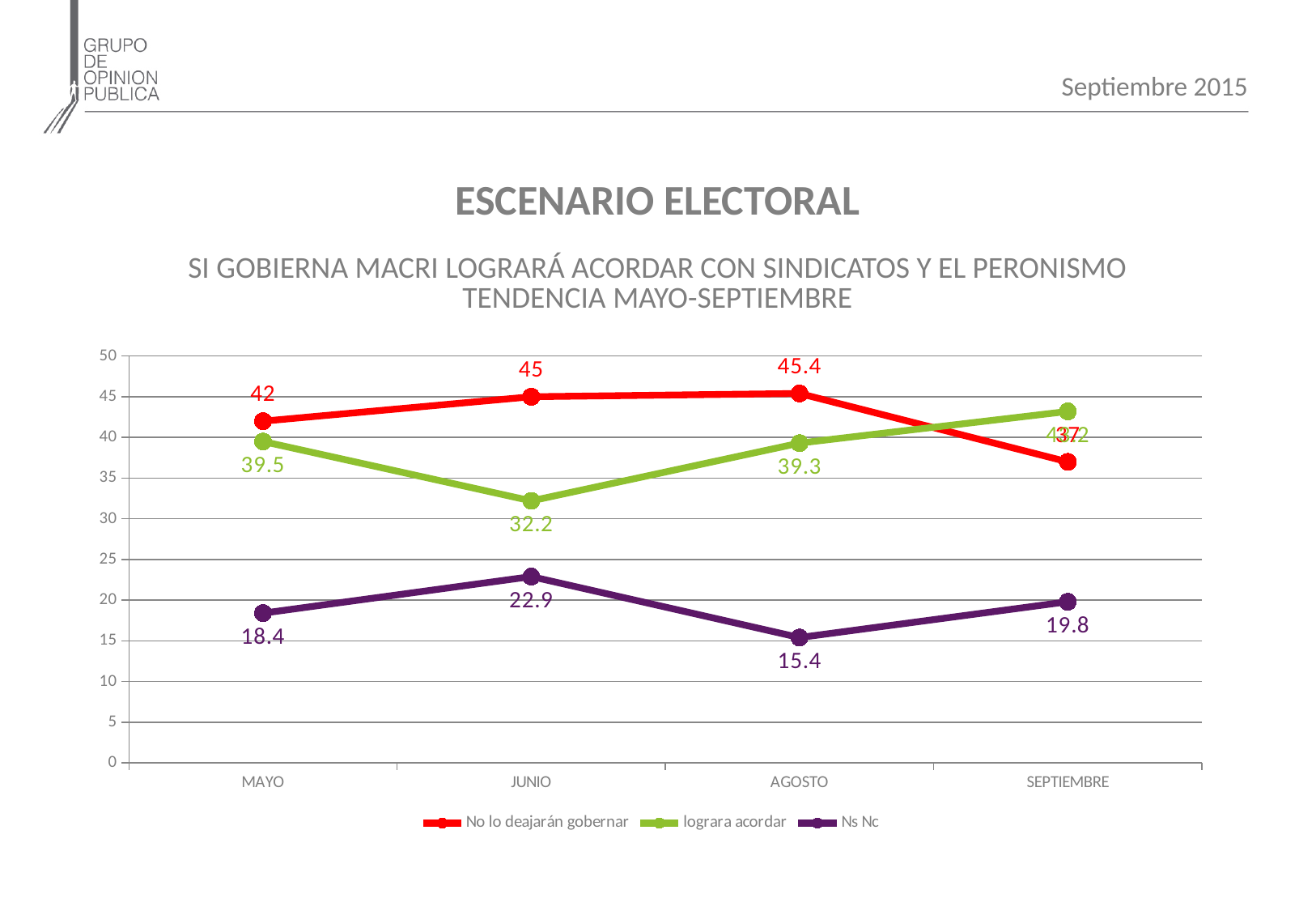
What is the difference between the "No lo deajarán gobernar" values in AGOSTO and MAYO? 3.4 What kind of chart is shown on the slide? line chart What is the value for "lograra acordar" in MAYO? 39.5 What is the value for "No lo deajarán gobernar" in JUNIO? 45 How many series does the legend list? 3 What is the value for "Ns Nc" in AGOSTO? 15.4 Does the "Ns Nc" series rise or fall from JUNIO to AGOSTO? fall In which month is the "lograra acordar" series lowest? JUNIO How many months are shown on the x axis? 4 In which month is the "Ns Nc" series highest? JUNIO Is the value for "lograra acordar" in SEPTIEMBRE greater or less than 40? greater In MAYO, which series has the larger value: "No lo deajarán gobernar" or "lograra acordar"? No lo deajarán gobernar